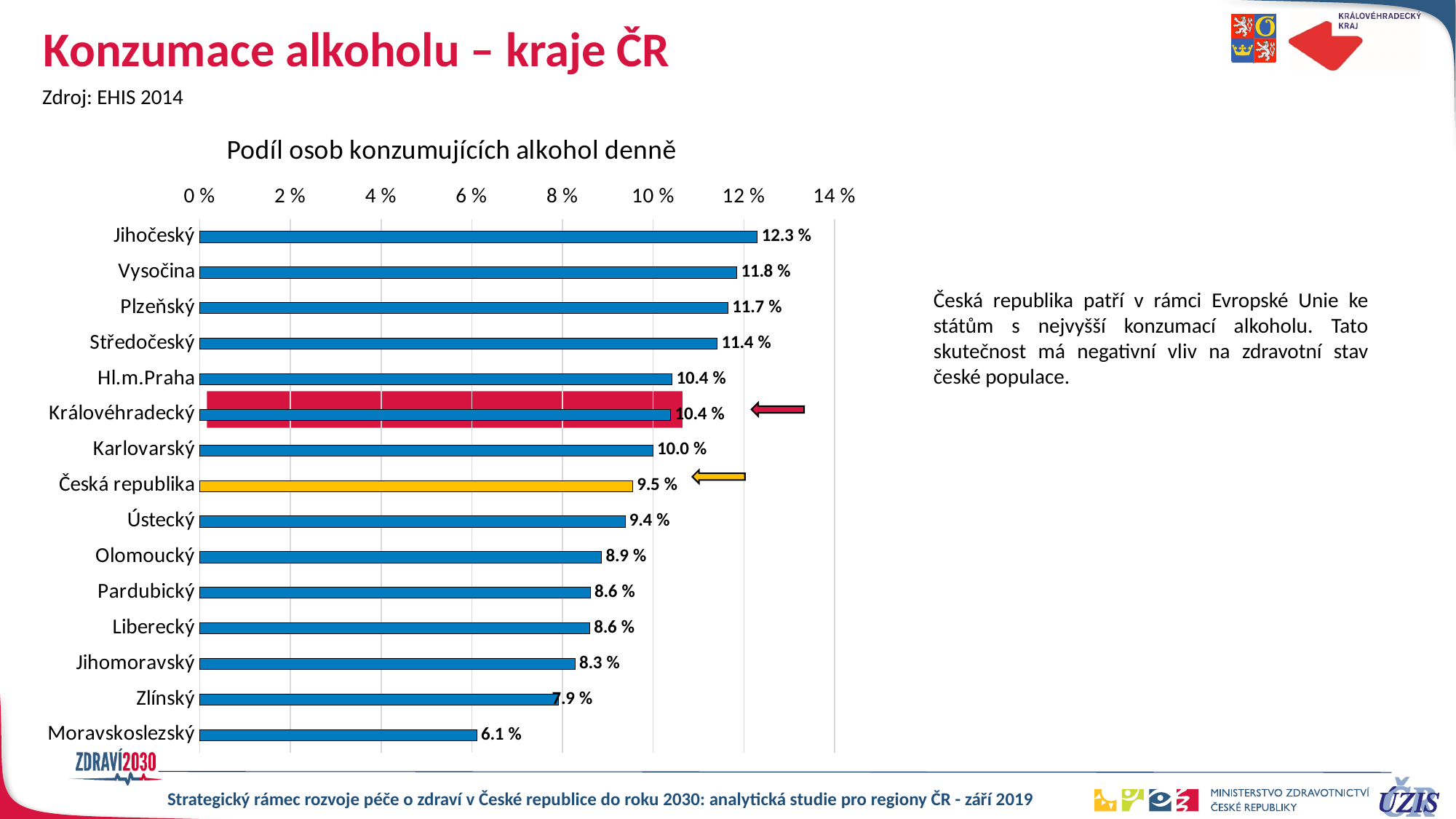
How many categories are shown on the chart? 15 What is the value for Moravskoslezský? 6.1 % What kind of chart is shown on the slide? Bar chart What is the title of the chart? Podíl osob konzumujících alkohol denně What is the difference between the values for Královéhradecký and Česká republika? 0.9 % What is the difference between the values for Jihočeský and Moravskoslezský? 6.2 % Which category has the lowest value? Moravskoslezský What is the value for Jihočeský? 12.3 % What is the value for Česká republika? 9.5 % Which is larger, the value for Vysočina or the value for Středočeský? Vysočina Which category has the highest value? Jihočeský What is the value for Královéhradecký? 10.4 %